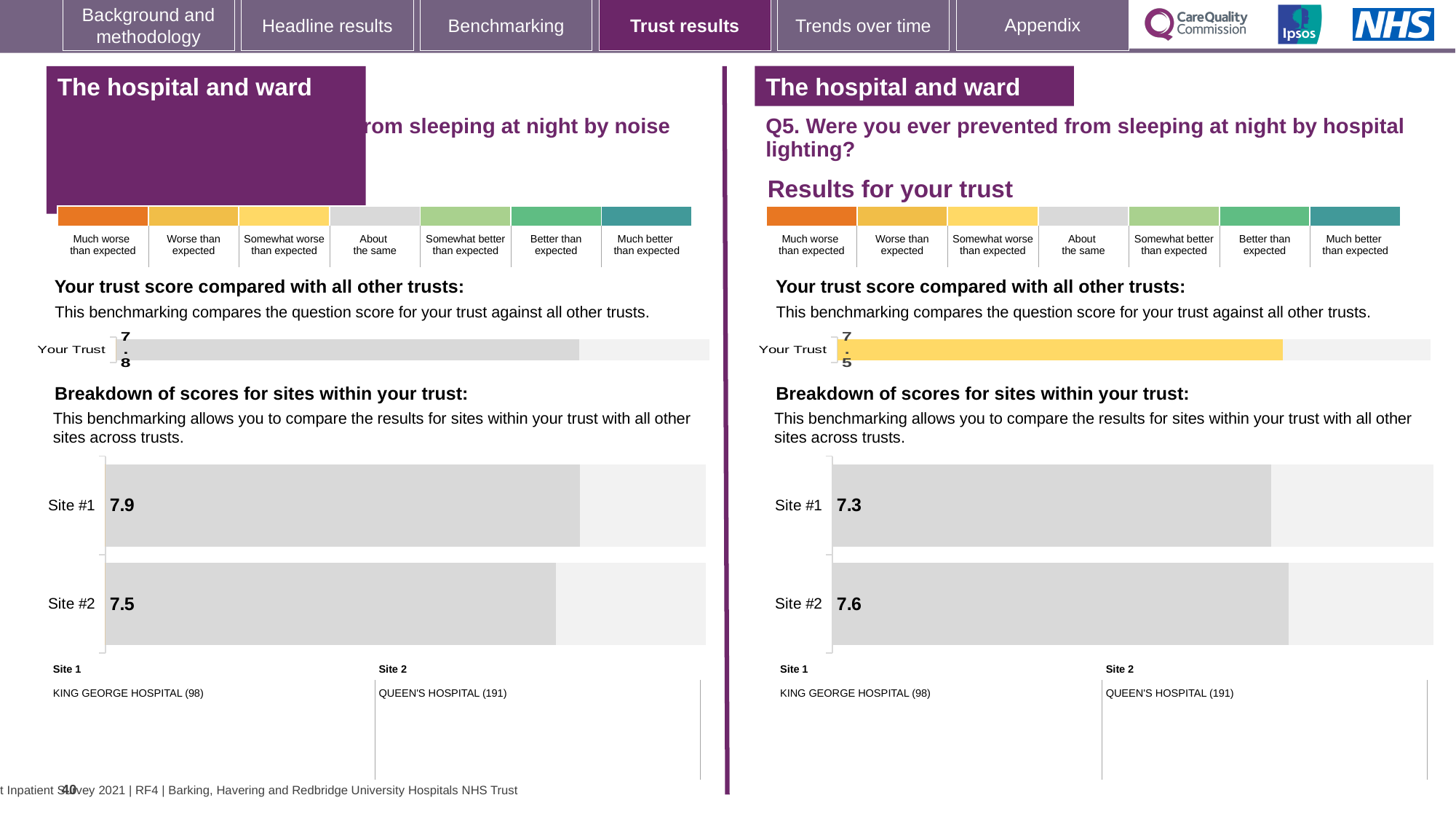
On the left-hand side of the slide (the question about noise), what is the 'Your Trust' score? 7.8 On the right-hand side of the slide (Q5, hospital lighting), what is the difference between the Site #2 and Site #1 scores? 0.3 On the left-hand side of the slide (the question about noise), what is the difference between the Site #1 and Site #2 scores? 0.4 On the left-hand side of the slide (the question about noise), which site has the higher score? Site #1 On the right-hand side of the slide (Q5, hospital lighting), what is the score for Site #2? 7.6 What type of chart is used for the site breakdown on the left-hand side of the slide? Bar chart On the right-hand side of the slide (Q5, hospital lighting), what is the score for Site #1? 7.3 On the left-hand side of the slide (the question about noise), what is the score for Site #2? 7.5 On the right-hand side of the slide (Q5, hospital lighting), which site has the lower score? Site #1 How many sites are shown in the site breakdown chart on the right-hand side of the slide? 2 On the left-hand side of the slide (the question about noise), what is the score for Site #1? 7.9 On the right-hand side of the slide (Q5, hospital lighting), what is the 'Your Trust' score? 7.5